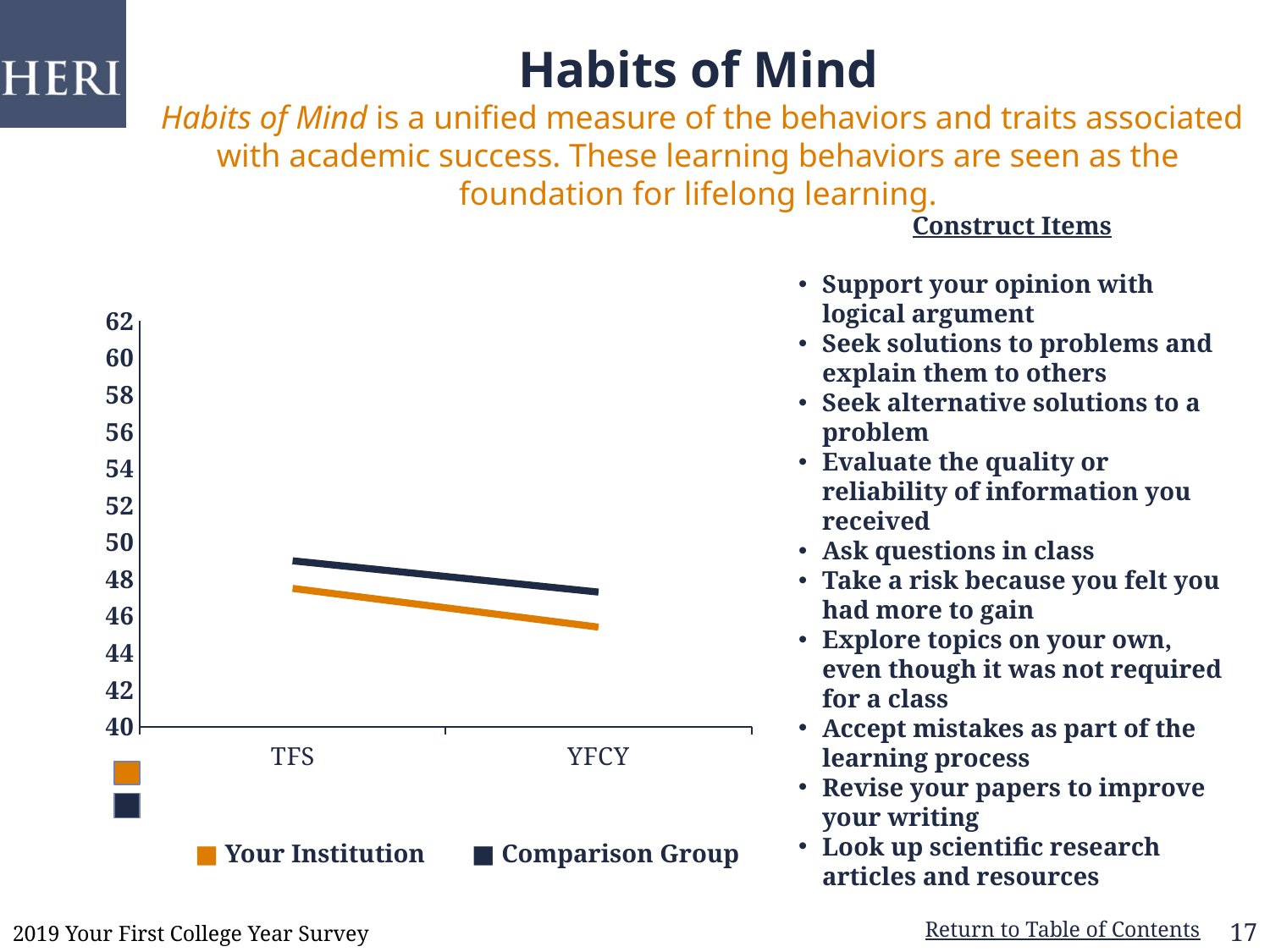
At YFCY, which is lower: Your Institution or Comparison Group? Your Institution Is the value for Comparison Group at TFS greater or less than 48? greater How many points are on the x axis of the chart? 2 What are the two labels on the x axis of the chart? TFS and YFCY How many series does the chart legend list? 2 Is the value for Your Institution at TFS greater or less than 50? less Does the Comparison Group line rise or fall from TFS to YFCY? fall Which colour represents Your Institution in the chart legend? orange What kind of chart is shown on the slide? line chart Is the value for Your Institution at YFCY greater or less than 48? less Does the Your Institution line rise or fall from TFS to YFCY? fall At TFS, which is higher: Your Institution or Comparison Group? Comparison Group